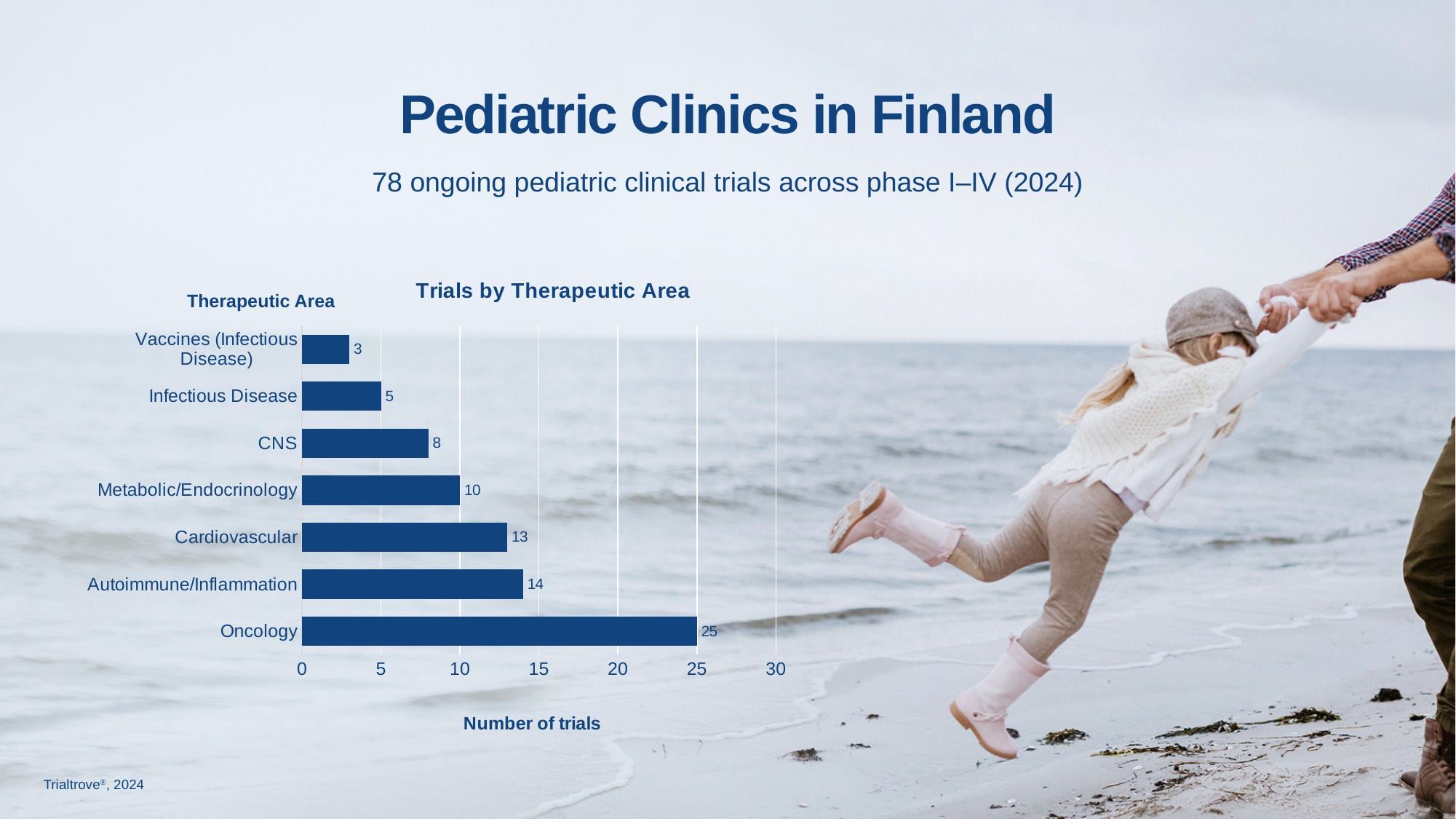
How many trials are shown for Oncology? 25 Which has more trials, CNS or Metabolic/Endocrinology? Metabolic/Endocrinology What is the number of trials for Cardiovascular? 13 Which therapeutic area has the lowest number of trials? Vaccines (Infectious Disease) What kind of chart is shown on the slide? Bar chart What is the label of the horizontal axis? Number of trials Which therapeutic area has the highest number of trials? Oncology Is the value for Infectious Disease greater or less than 10? less How many trials are shown for Vaccines (Infectious Disease)? 3 What is the title of the chart? Trials by Therapeutic Area What is the difference in number of trials between Oncology and Autoimmune/Inflammation? 11 How many therapeutic areas are shown in the chart? 7